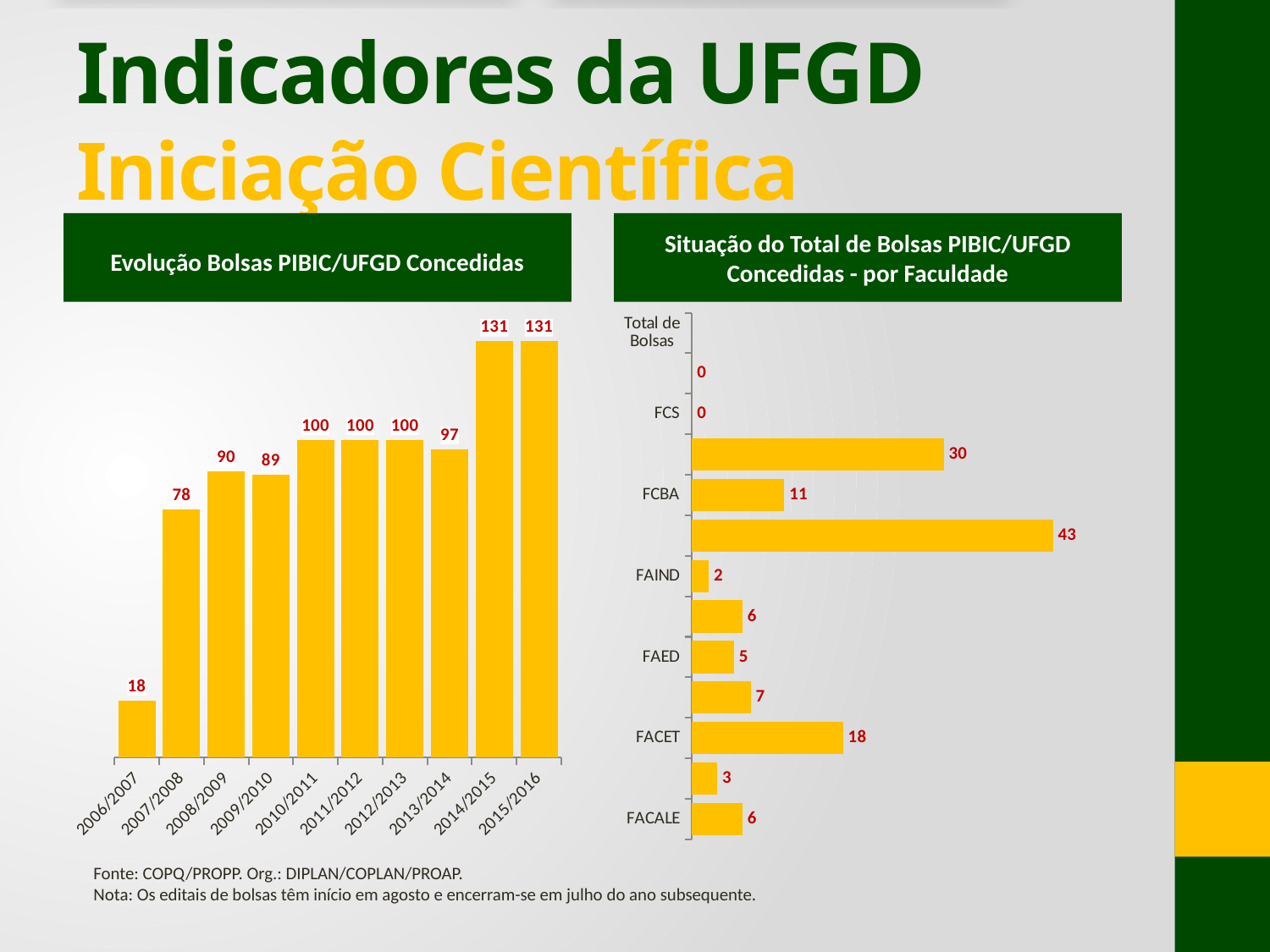
In the chart 'Evolução Bolsas PIBIC/UFGD Concedidas', what is the value for 2014/2015? 131 In the chart 'Evolução Bolsas PIBIC/UFGD Concedidas', what is the highest value shown? 131 What kind of chart is 'Evolução Bolsas PIBIC/UFGD Concedidas'? bar chart In the chart 'Evolução Bolsas PIBIC/UFGD Concedidas', do the values generally rise or fall from 2006/2007 to 2015/2016? rise In the chart 'Situação do Total de Bolsas PIBIC/UFGD Concedidas - por Faculdade', what is the value for FACET? 18 In the chart 'Evolução Bolsas PIBIC/UFGD Concedidas', what is the difference between the values for 2007/2008 and 2006/2007? 60 In the chart 'Situação do Total de Bolsas PIBIC/UFGD Concedidas - por Faculdade', which is larger, the value for FCBA or FACALE? FCBA In the chart 'Evolução Bolsas PIBIC/UFGD Concedidas', which is larger, the value for 2008/2009 or 2009/2010? 2008/2009 How many years are shown in the chart 'Evolução Bolsas PIBIC/UFGD Concedidas'? 10 In the chart 'Evolução Bolsas PIBIC/UFGD Concedidas', what is the value for 2006/2007? 18 In the chart 'Evolução Bolsas PIBIC/UFGD Concedidas', which year has the lowest value? 2006/2007 In the chart 'Situação do Total de Bolsas PIBIC/UFGD Concedidas - por Faculdade', what is the difference between the values for FACET and FAED? 13